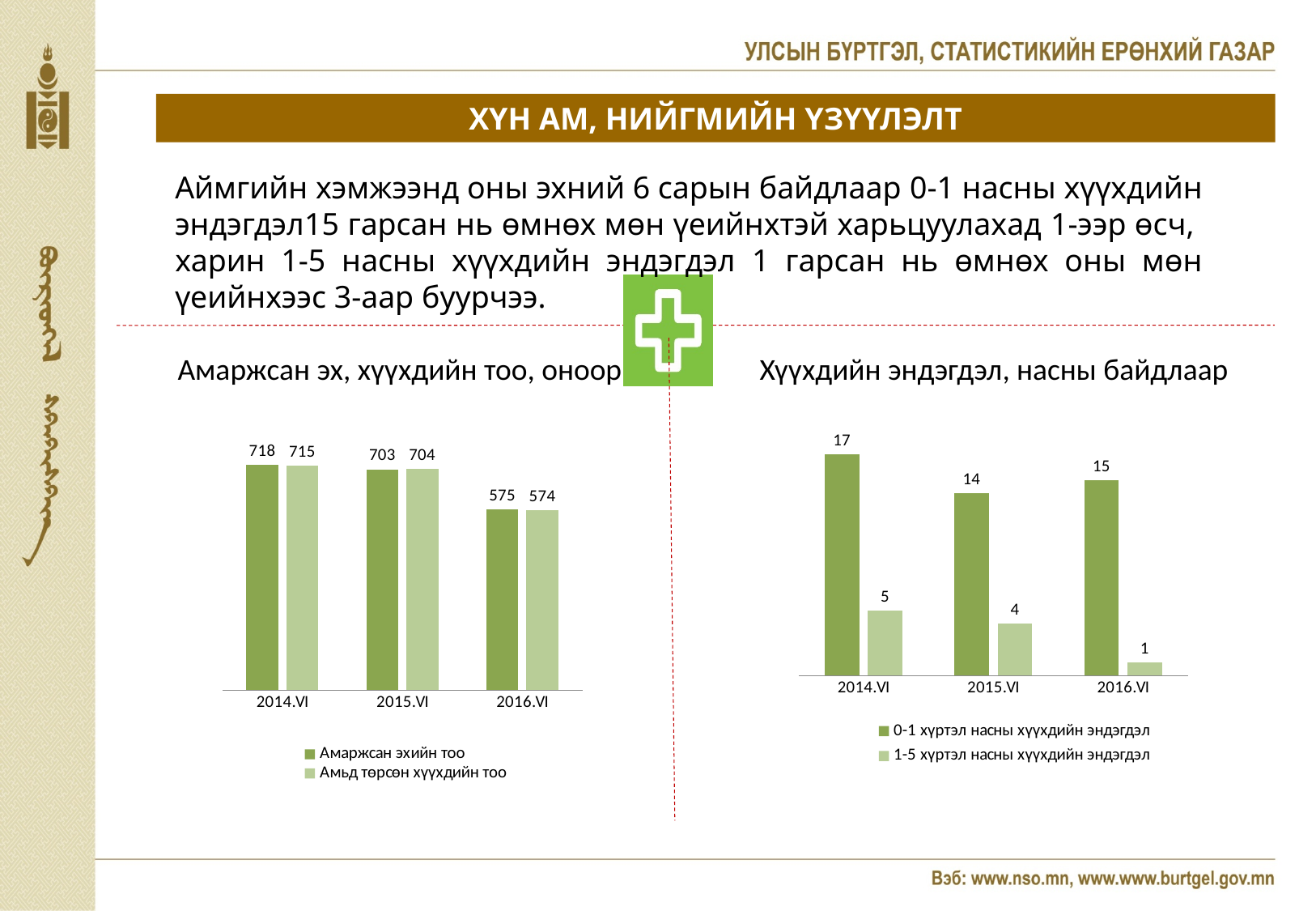
In the left chart (Амаржсан эх, хүүхдийн тоо, оноор), how many series does the legend list? 2 In the left chart (Амаржсан эх, хүүхдийн тоо, оноор), does Амьд төрсөн хүүхдийн тоо rise or fall from 2014.VI to 2016.VI? fall In the right chart (Хүүхдийн эндэгдэл, насны байдлаар), what is the difference between 0-1 хүртэл насны хүүхдийн эндэгдэл and 1-5 хүртэл насны хүүхдийн эндэгдэл in 2014.VI? 12 In the left chart (Амаржсан эх, хүүхдийн тоо, оноор), what is the difference between Амаржсан эхийн тоо in 2014.VI and 2016.VI? 143 In the right chart (Хүүхдийн эндэгдэл, насны байдлаар), which year has the highest value for 0-1 хүртэл насны хүүхдийн эндэгдэл? 2014.VI What kind of chart is the right chart (Хүүхдийн эндэгдэл, насны байдлаар)? bar chart In the left chart (Амаржсан эх, хүүхдийн тоо, оноор), which year has the lowest value for Амаржсан эхийн тоо? 2016.VI In the right chart (Хүүхдийн эндэгдэл, насны байдлаар), what is the value of 0-1 хүртэл насны хүүхдийн эндэгдэл for 2015.VI? 14 In the right chart (Хүүхдийн эндэгдэл, насны байдлаар), what is the value of 1-5 хүртэл насны хүүхдийн эндэгдэл for 2016.VI? 1 In the left chart (Амаржсан эх, хүүхдийн тоо, оноор), what is the value of Амаржсан эхийн тоо for 2014.VI? 718 In the left chart (Амаржсан эх, хүүхдийн тоо, оноор), what is the value of Амьд төрсөн хүүхдийн тоо for 2016.VI? 574 In the right chart (Хүүхдийн эндэгдэл, насны байдлаар), how many years are shown on the x axis? 3